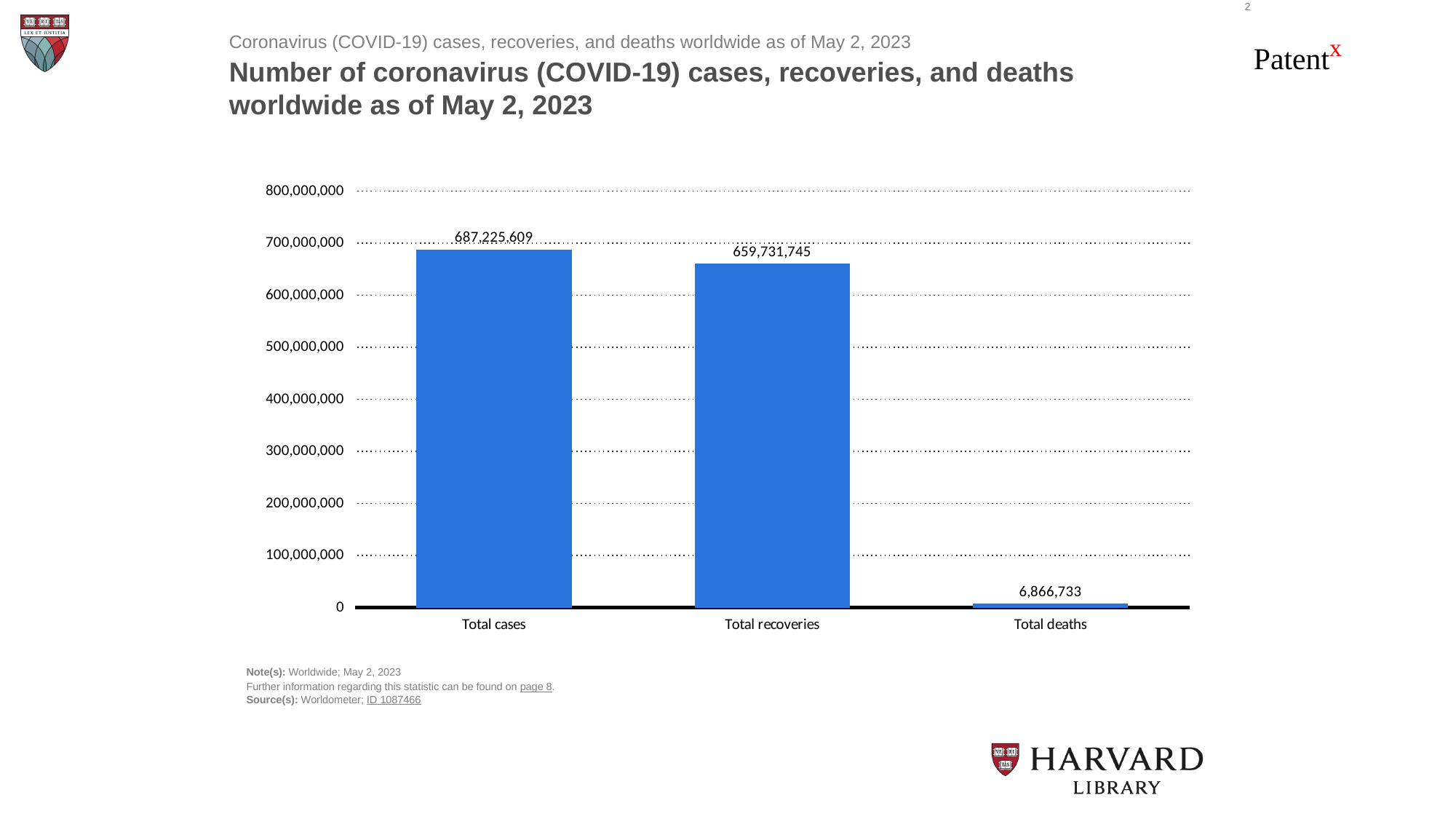
What is the difference between Total recoveries and Total deaths? 652,865,012 What kind of chart is shown on the slide? Bar chart What is the title of the chart? Number of coronavirus (COVID-19) cases, recoveries, and deaths worldwide as of May 2, 2023 What is the difference between Total cases and Total recoveries? 27,493,864 How many categories are shown on the x axis? 3 Which category has the lowest value? Total deaths Which category has the highest value? Total cases What is the value for Total deaths? 6,866,733 Which is larger, Total recoveries or Total deaths? Total recoveries What is the value for Total cases? 687,225,609 What is the value for Total recoveries? 659,731,745 Is the value for Total recoveries greater or less than 700,000,000? less